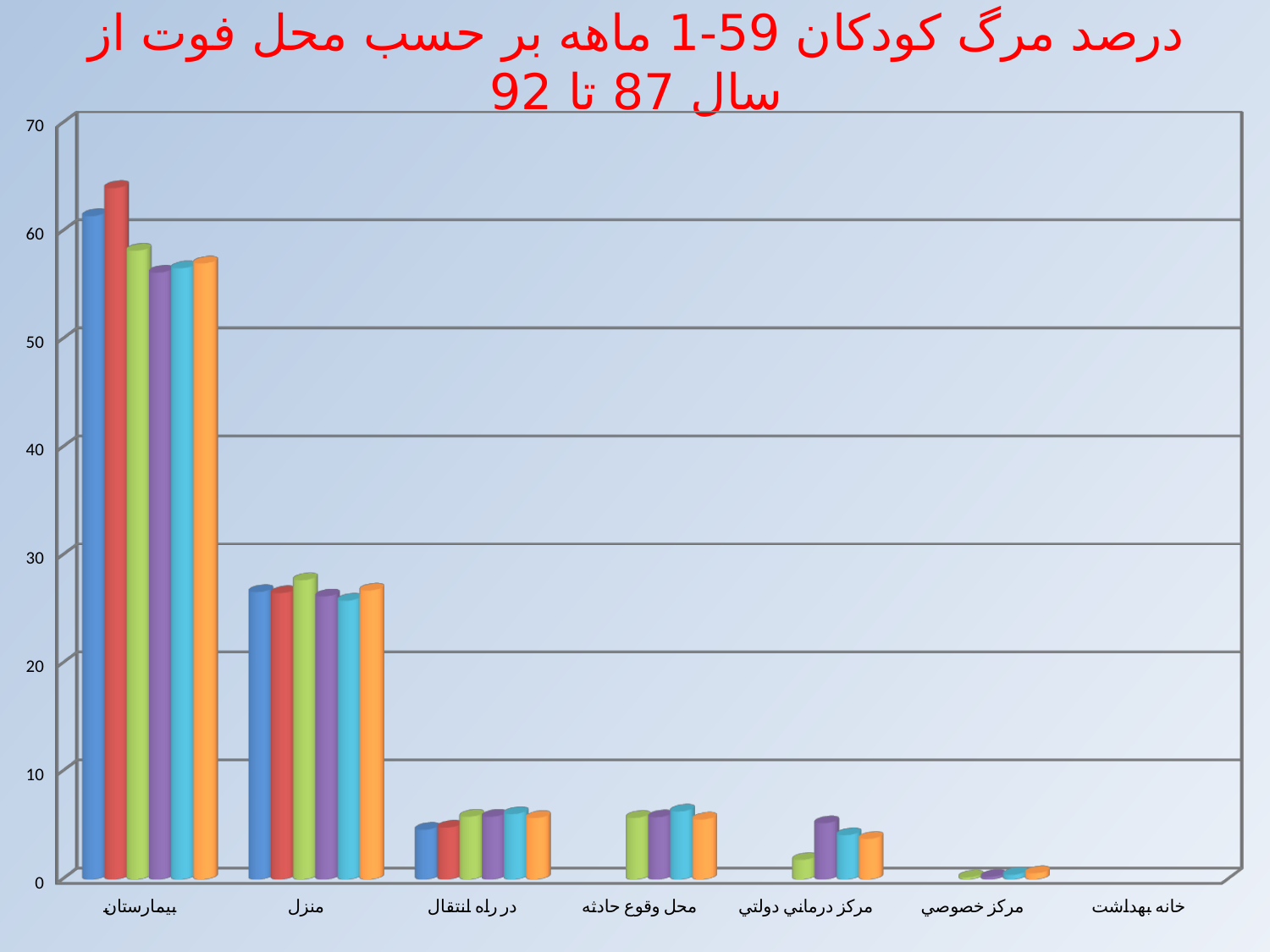
Which category has the lowest values, with bars barely visible? مركز خصوصي What is the highest value shown on the vertical axis? 70 Which category has larger values, بیمارستان or منزل? بیمارستان Are the values for در راه انتقال greater or less than 10? less Is the value of the purple bar for مرکز درماني دولتي greater or less than 10? less Is the value of the red bar for بیمارستان greater or less than 60? greater How many categories are shown along the horizontal axis? 7 Which category has the highest bars? بیمارستان What kind of chart is shown on the slide? bar chart Do the values generally rise or fall moving from left to right across the categories? fall Which category has larger values, در راه انتقال or مرکز خصوصي? در راه انتقال